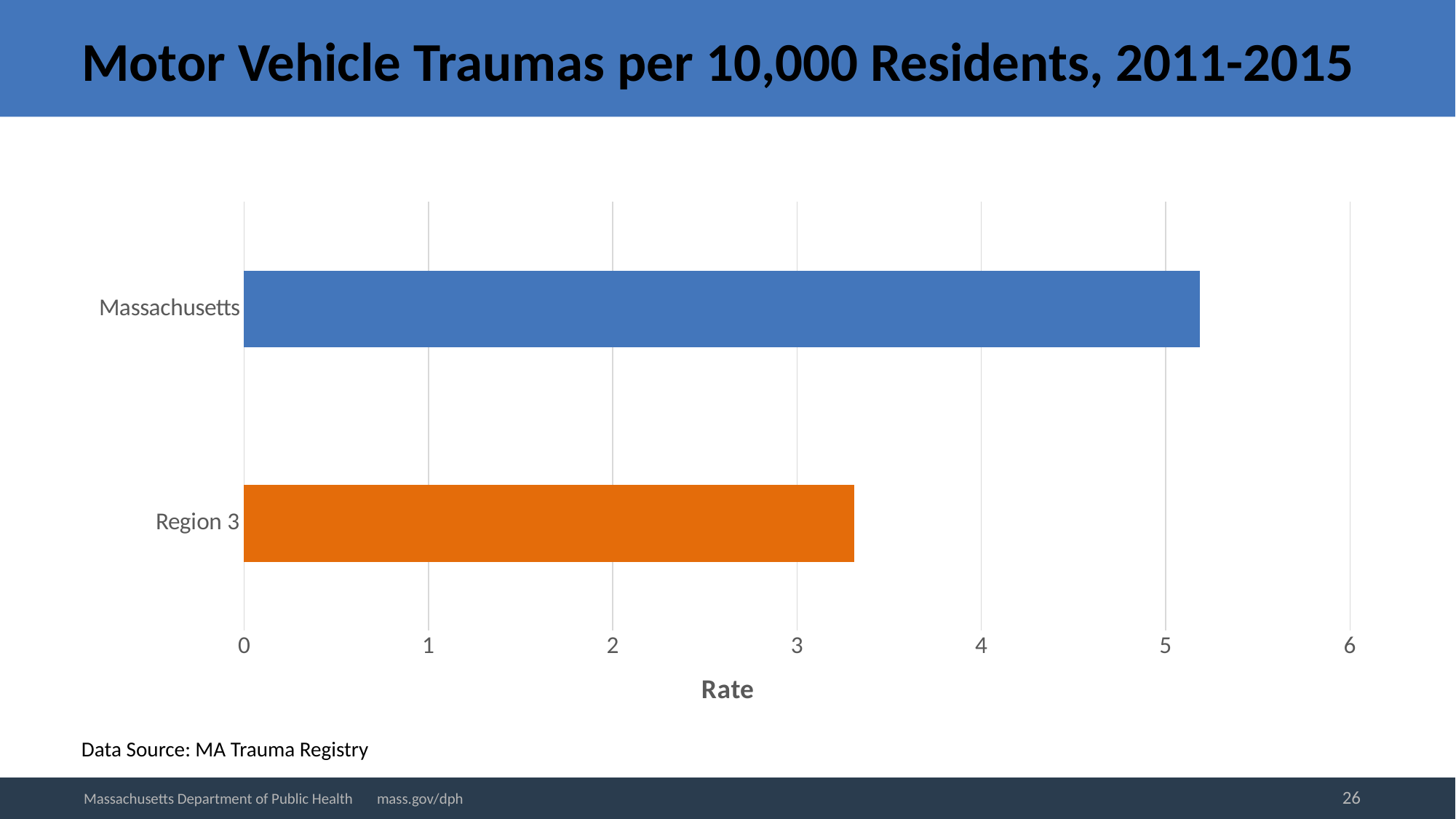
How many categories are plotted in the chart? 2 What kind of chart is shown on the slide? bar chart Is the value for Region 3 greater or less than 4? less Which has a higher rate, Massachusetts or Region 3? Massachusetts Is the value for Region 3 greater or less than 3? greater Which category has the lowest rate? Region 3 What is the label of the horizontal axis? Rate Is the value for Massachusetts greater or less than 5? greater Which category has the highest rate? Massachusetts What is the title of the chart? Motor Vehicle Traumas per 10,000 Residents, 2011-2015